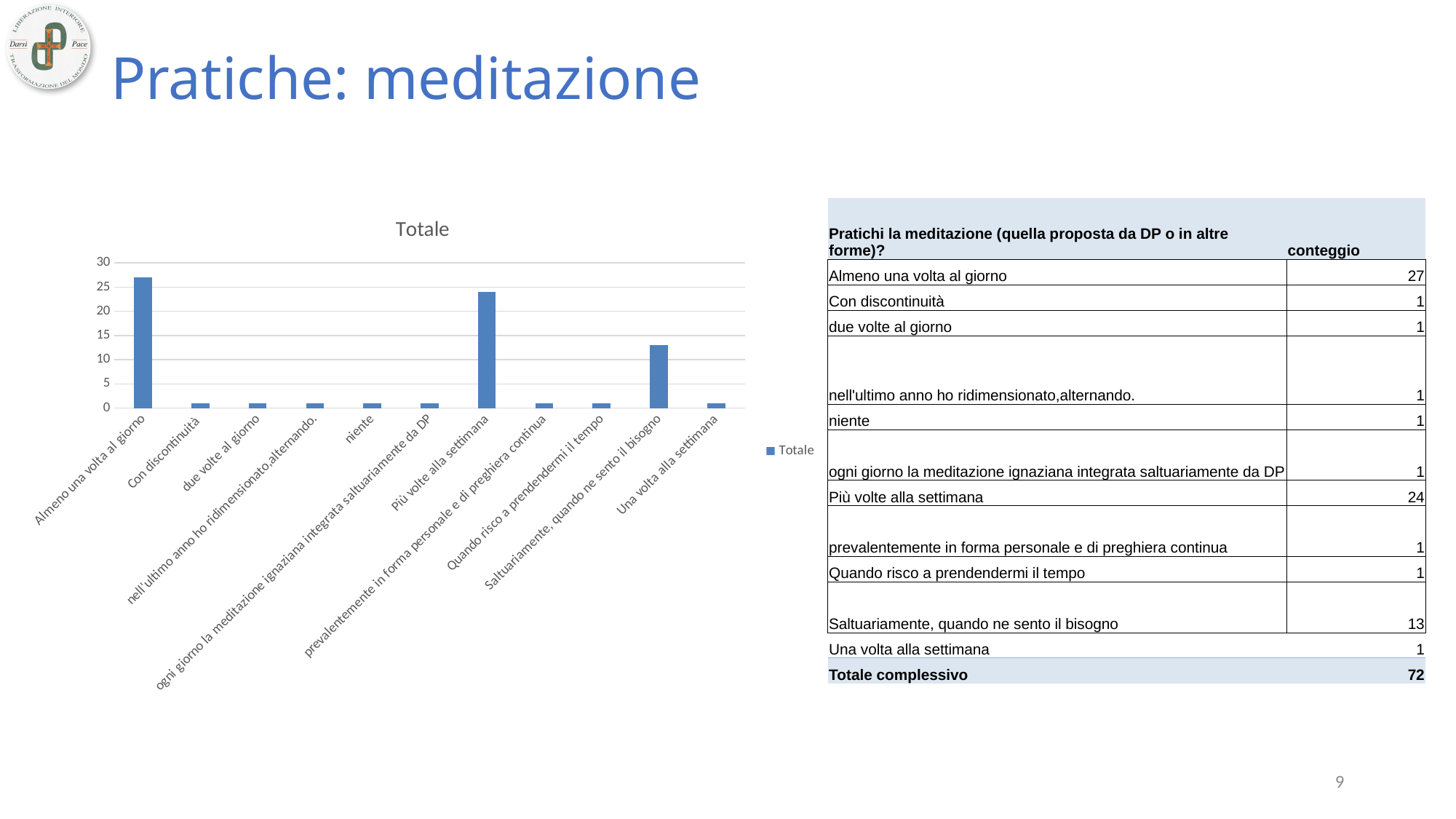
What is the value for 'Saltuariamente, quando ne sento il bisogno'? 13 What is the difference between the values for 'Almeno una volta al giorno' and 'Più volte alla settimana'? 3 Is the value for 'Saltuariamente, quando ne sento il bisogno' greater or less than 10? greater How many categories are shown on the x axis of the chart? 11 What is the value for 'Più volte alla settimana'? 24 What is the value for 'Con discontinuità'? 1 What is the title of the chart? Totale Which is larger, the value for 'Più volte alla settimana' or the value for 'Saltuariamente, quando ne sento il bisogno'? Più volte alla settimana What is the value for 'Almeno una volta al giorno'? 27 How many series does the chart legend list? 1 What kind of chart is shown on the slide? bar chart Which category has the highest value in the chart? Almeno una volta al giorno